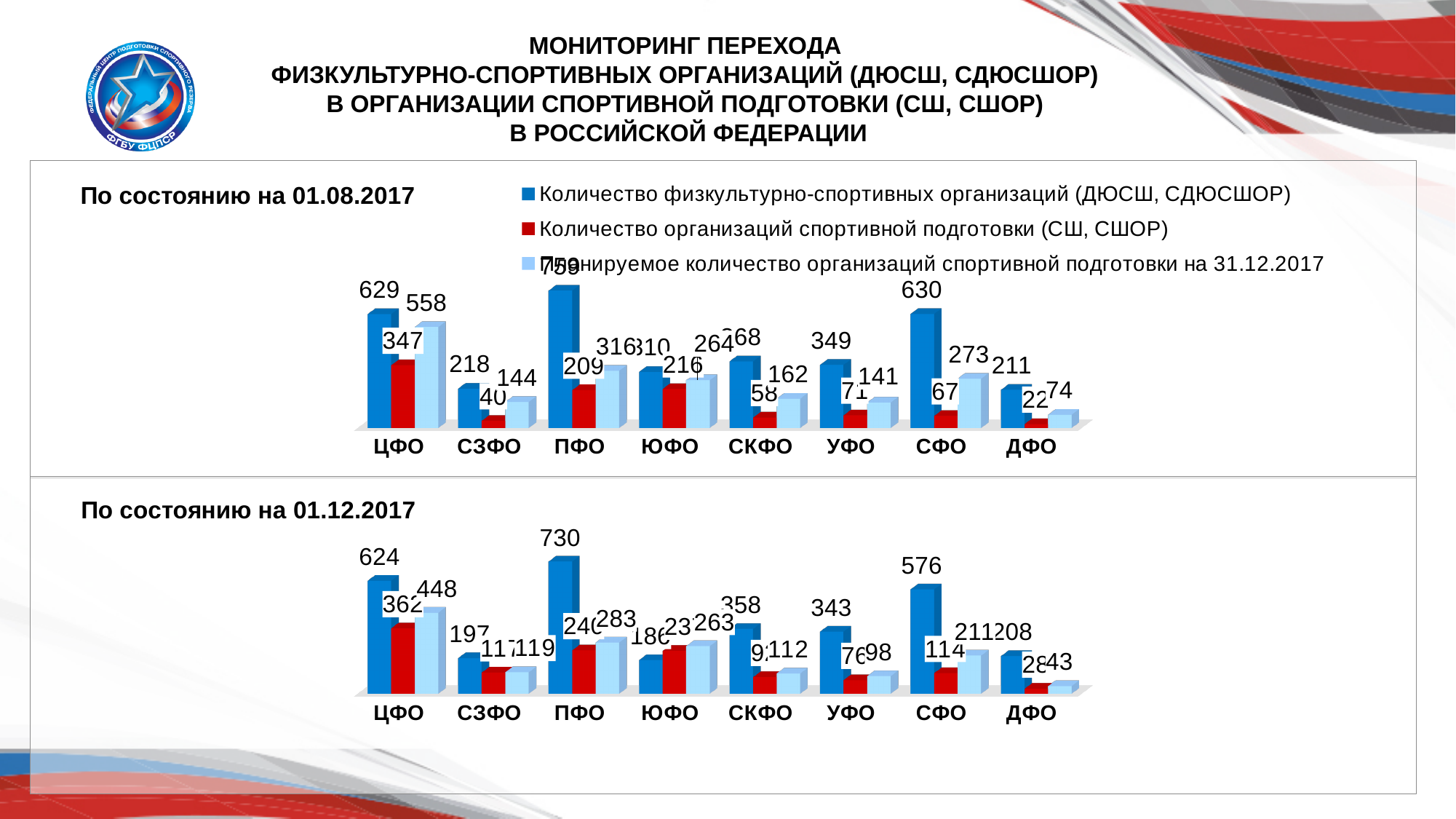
In the bottom chart (По состоянию на 01.12.2017), which category has the highest value for Количество физкультурно-спортивных организаций (ДЮСШ, СДЮСШОР)? ПФО In the top chart (По состоянию на 01.08.2017), which is larger for УФО: the ДЮСШ, СДЮСШОР value or the planned value for 31.12.2017? ДЮСШ, СДЮСШОР value (349) In the top chart (По состоянию на 01.08.2017), which category has the lowest value for Количество организаций спортивной подготовки (СШ, СШОР)? ДФО In the bottom chart (По состоянию на 01.12.2017), what is the difference between the ДЮСШ, СДЮСШОР value (624) and the СШ, СШОР value (362) for ЦФО? 262 How many categories are shown on the x axis of the bottom chart (По состоянию на 01.12.2017)? 8 How many series does the legend of the top chart list? 3 In the bottom chart (По состоянию на 01.12.2017), what is the value of Количество физкультурно-спортивных организаций (ДЮСШ, СДЮСШОР) for ПФО? 730 In the top chart (По состоянию на 01.08.2017), what is the value of Количество физкультурно-спортивных организаций (ДЮСШ, СДЮСШОР) for ЦФО? 629 In the top chart (По состоянию на 01.08.2017), what is the value of Количество организаций спортивной подготовки (СШ, СШОР) for СЗФО? 40 In the top chart (По состоянию на 01.08.2017), what is the planned number of sports training organisations (light blue series) for СФО? 273 What type of chart is used for the data as of 01.08.2017? Bar chart In the bottom chart (По состоянию на 01.12.2017), what is the value of Количество организаций спортивной подготовки (СШ, СШОР) for СФО? 114